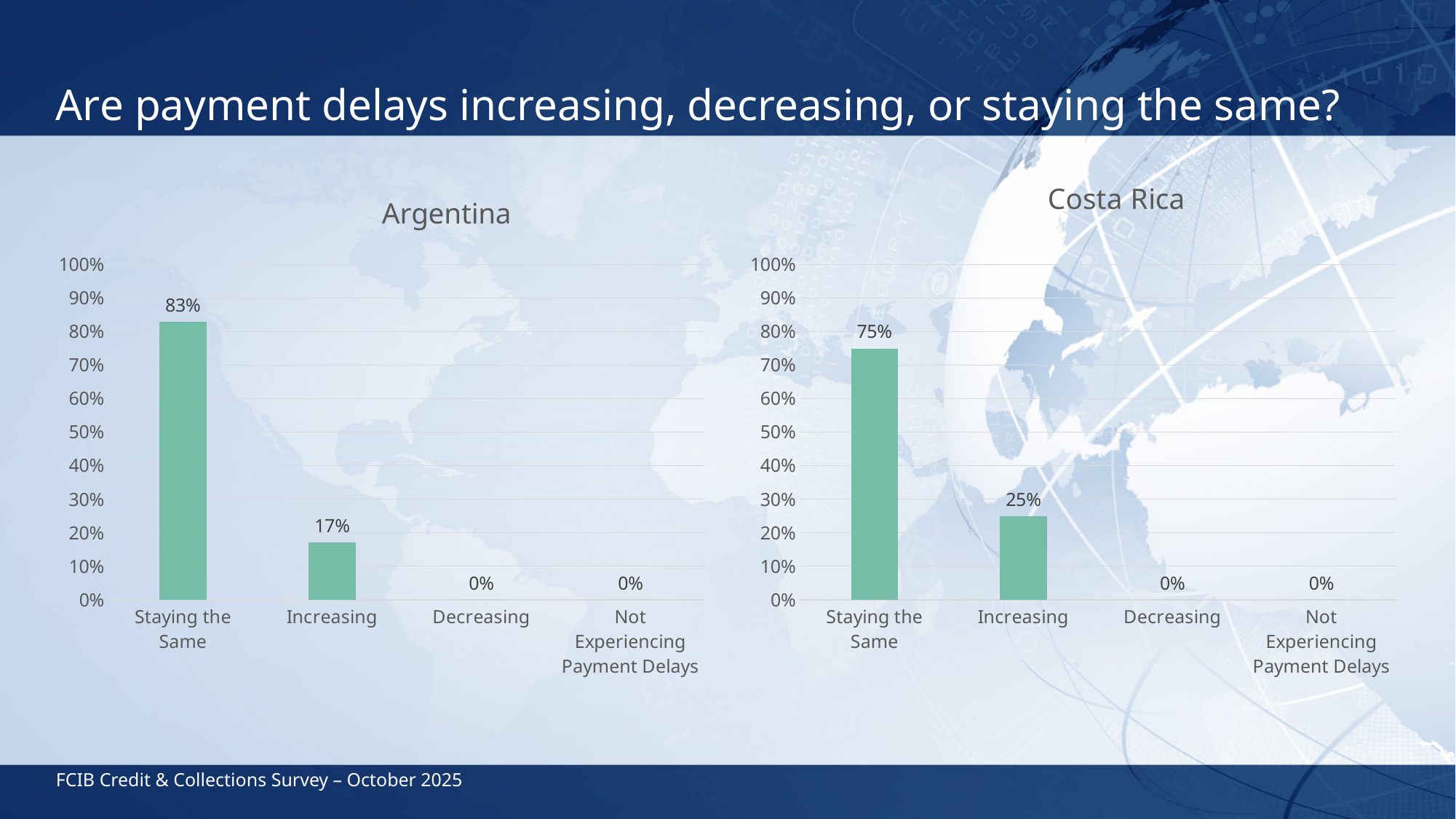
In the Costa Rica chart, what is the value for Staying the Same? 75% Which is larger: Staying the Same in the Argentina chart or Staying the Same in the Costa Rica chart? Argentina What kind of chart is the Argentina chart? Bar chart In the Argentina chart, what is the value for Staying the Same? 83% In the Argentina chart, what is the difference between Staying the Same and Increasing? 66% In the Argentina chart, what is the value for Increasing? 17% In the Costa Rica chart, what is the value for Increasing? 25% In the Argentina chart, which category has the highest value? Staying the Same How many categories are shown on the x axis of the Costa Rica chart? 4 What is the title of the chart on the right side of the slide? Costa Rica In the Costa Rica chart, what is the difference between Staying the Same and Increasing? 50% In the Costa Rica chart, what is the value for Decreasing? 0%